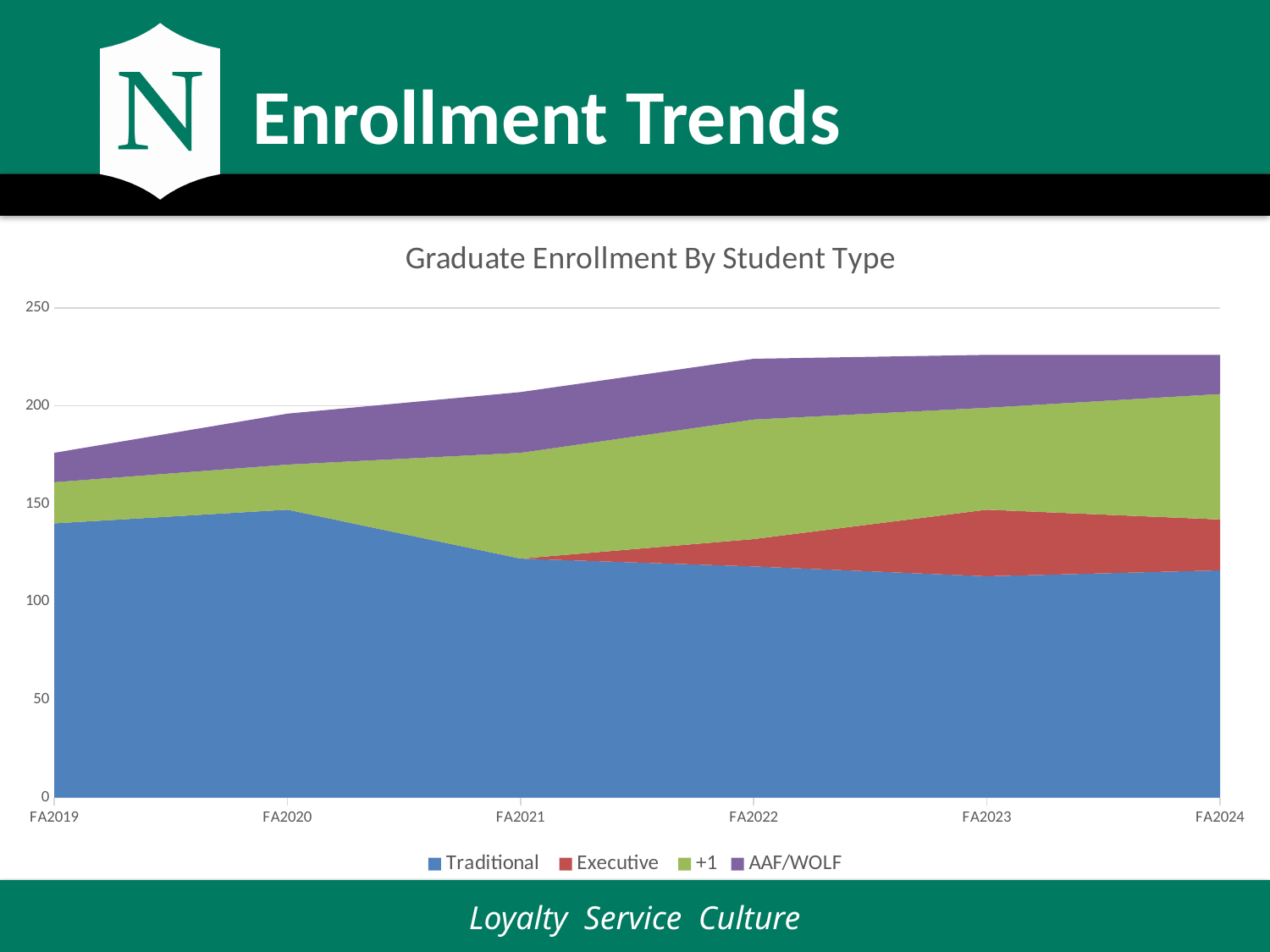
Does the total stacked enrollment rise or fall from FA2019 to FA2024? rise How many series does the legend list? 4 Which term has the lowest total stacked enrollment? FA2019 Is the value for Traditional at FA2019 greater or less than 100? greater Is the total stacked enrollment at FA2024 greater or less than 200? greater Is the total stacked enrollment at FA2019 greater or less than 200? less Is the Traditional value larger at FA2019 or at FA2024? FA2019 What kind of chart is shown on the slide? area chart How many terms are shown along the x axis? 6 Which series is shown in purple in the legend? AAF/WOLF What is the title of the chart? Graduate Enrollment By Student Type